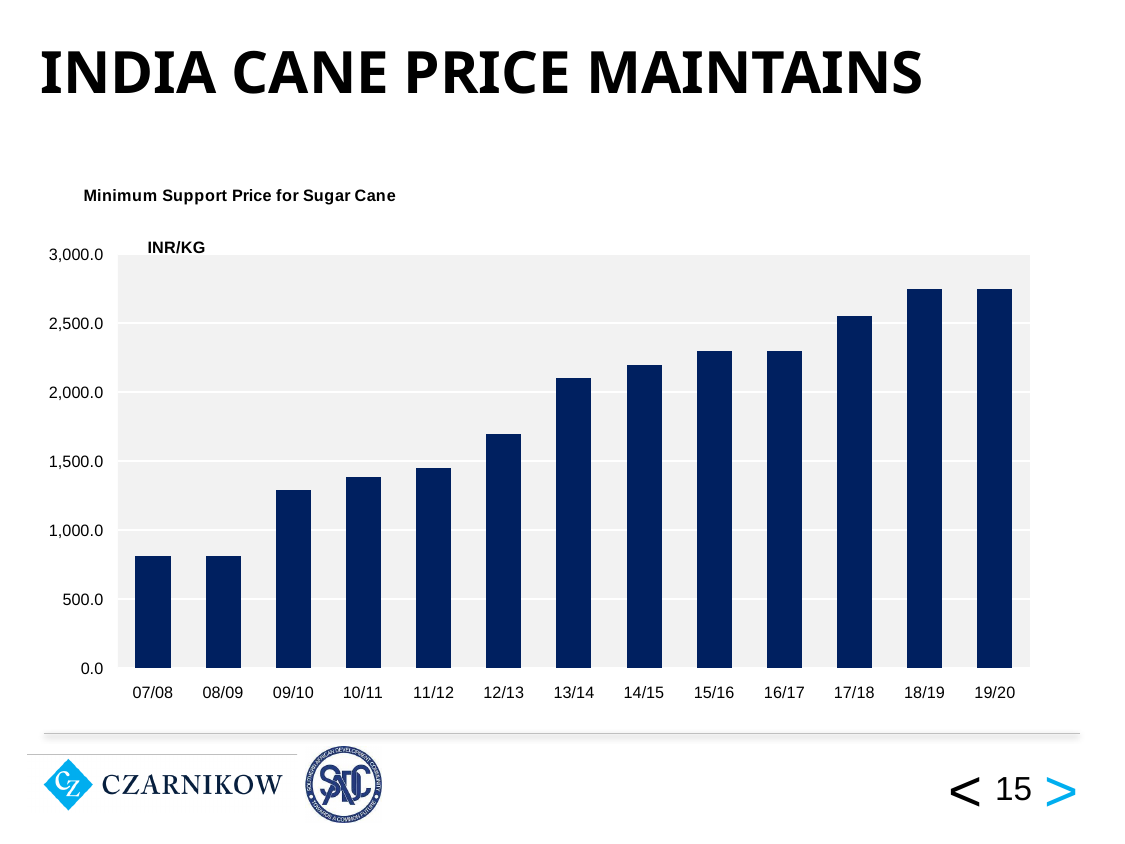
Which is larger, the value for 10/11 or the value for 14/15? 14/15 What kind of chart is shown on the slide? Bar chart Is the value for 17/18 greater or less than 2,500.0? greater How many seasons (categories) are plotted on the x axis? 13 Is the value for 12/13 greater or less than 1,500.0? greater What unit is shown for the values on the chart? INR/KG Is the value for 07/08 greater or less than 1,000.0? less Do the values generally rise or fall from 07/08 to 19/20? Rise What is the title of the chart? Minimum Support Price for Sugar Cane